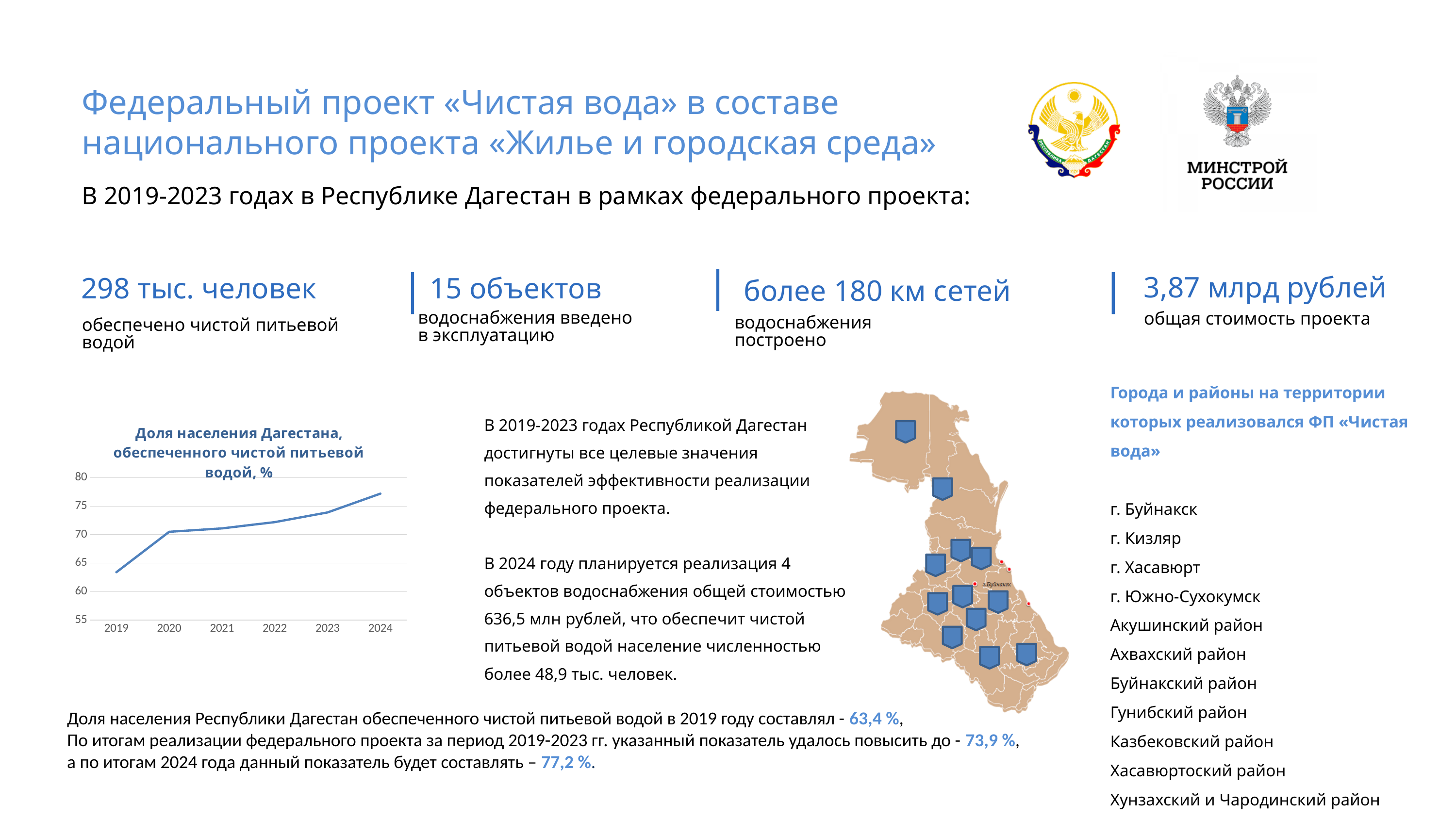
Do the values in the chart rise or fall from 2019 to 2024? rise What kind of chart is shown on the slide? line chart Is the value for 2022 greater or less than 75? less What is the title of the chart on the slide? Доля населения Дагестана, обеспеченного чистой питьевой водой, % Which year has the highest value in the chart? 2024 Is the value for 2019 greater or less than 65? less According to the slide, what was the share of the population of Dagestan provided with clean drinking water in 2019? 63,4 % How many years are plotted on the x axis of the chart? 6 Which year has the larger value in the chart, 2021 or 2023? 2023 Is the value for 2020 greater or less than 65? greater Which year has the lowest value in the chart? 2019